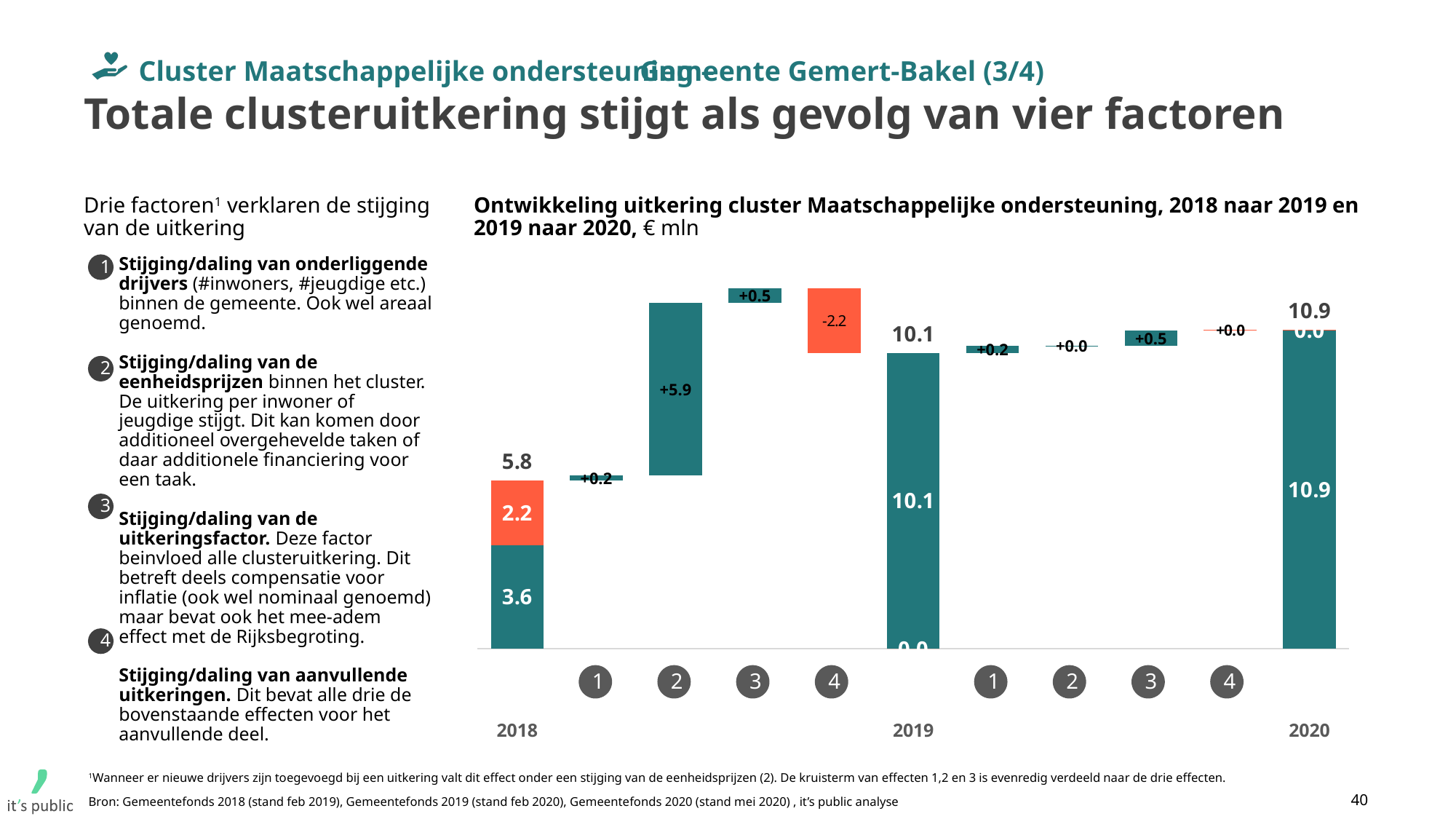
What is the effect of factor 2 in the step from 2018 to 2019? +5.9 What is the effect of factor 4 in the step from 2018 to 2019? -2.2 Which factor has the largest effect in the step from 2018 to 2019? Factor 2 Do the yearly totals rise or fall from 2018 to 2020? rise What is the total uitkering for 2018 shown on the chart? 5.8 What is the total uitkering for 2020 shown on the chart? 10.9 By how much does the total uitkering increase from 2018 to 2020? 5.1 What is the total uitkering for 2019 shown on the chart? 10.1 How many factors are shown between each pair of years on the chart? 4 What is the effect of factor 3 in the step from 2019 to 2020? +0.5 What kind of chart is shown on the slide? bar chart (waterfall)